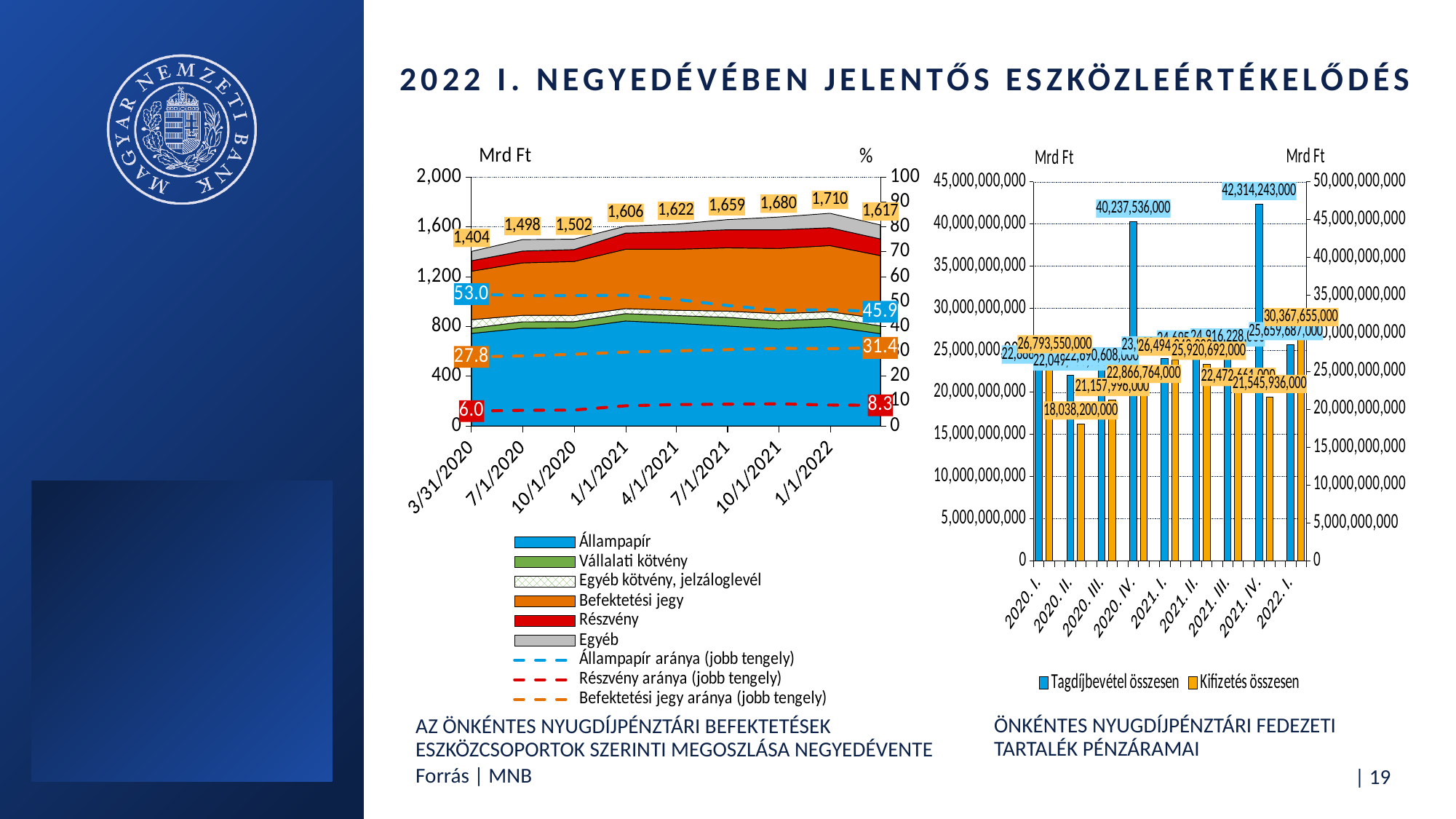
On the right chart, what is the Tagdíjbevétel összesen value for 2021. IV.? 42,314,243,000 On the left chart, does the Befektetési jegy aránya (jobb tengely) line rise or fall from its first label (27.8) to its last label (31.4)? rise On the left chart, what is the highest total value labelled across the quarters? 1,710 On the left chart, what is the total value labelled for 3/31/2020? 1,404 On the left chart, what is the first labelled value of the Állampapír aránya (jobb tengely) line? 53.0 What kind of chart is the right chart? bar chart On the left chart, what is the total value labelled for 1/1/2022? 1,710 On the left chart, what is the difference between the total labelled for 1/1/2022 (1,710) and the last labelled total (1,617)? 93 On the left chart, what is the last labelled value of the Részvény aránya (jobb tengely) line? 8.3 On the right chart, what is the Kifizetés összesen value for 2020. II.? 18,038,200,000 On the left chart, what is the lowest total value labelled across the quarters? 1,404 How many entries does the legend of the left chart list? 9